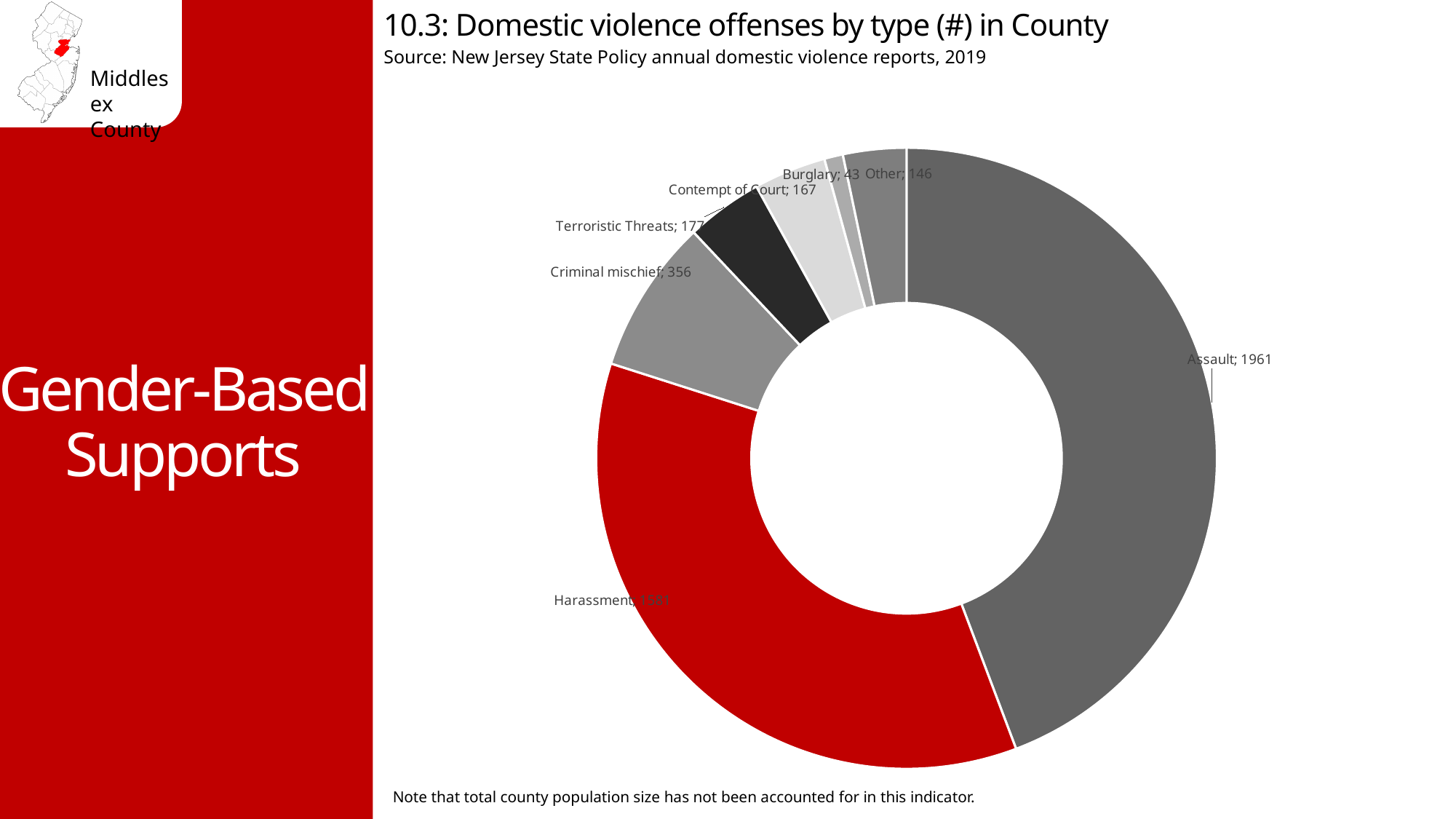
What is the value shown for Contempt of Court? 167 How many offense types are shown on the chart? 7 Which offense type has the lowest number of offenses? Burglary What is the difference between the values for Terroristic Threats and Contempt of Court? 10 Which offense type has the highest number of offenses? Assault What kind of chart is shown on the slide? Doughnut (pie) chart What is the value shown for Burglary? 43 What is the value shown for Criminal mischief? 356 Which is larger, the value for Assault or the value for Harassment? Assault What is the value shown for Other? 146 How many domestic violence offenses of type Assault are shown on the chart? 1961 What is the difference between the values for Criminal mischief and Other? 210